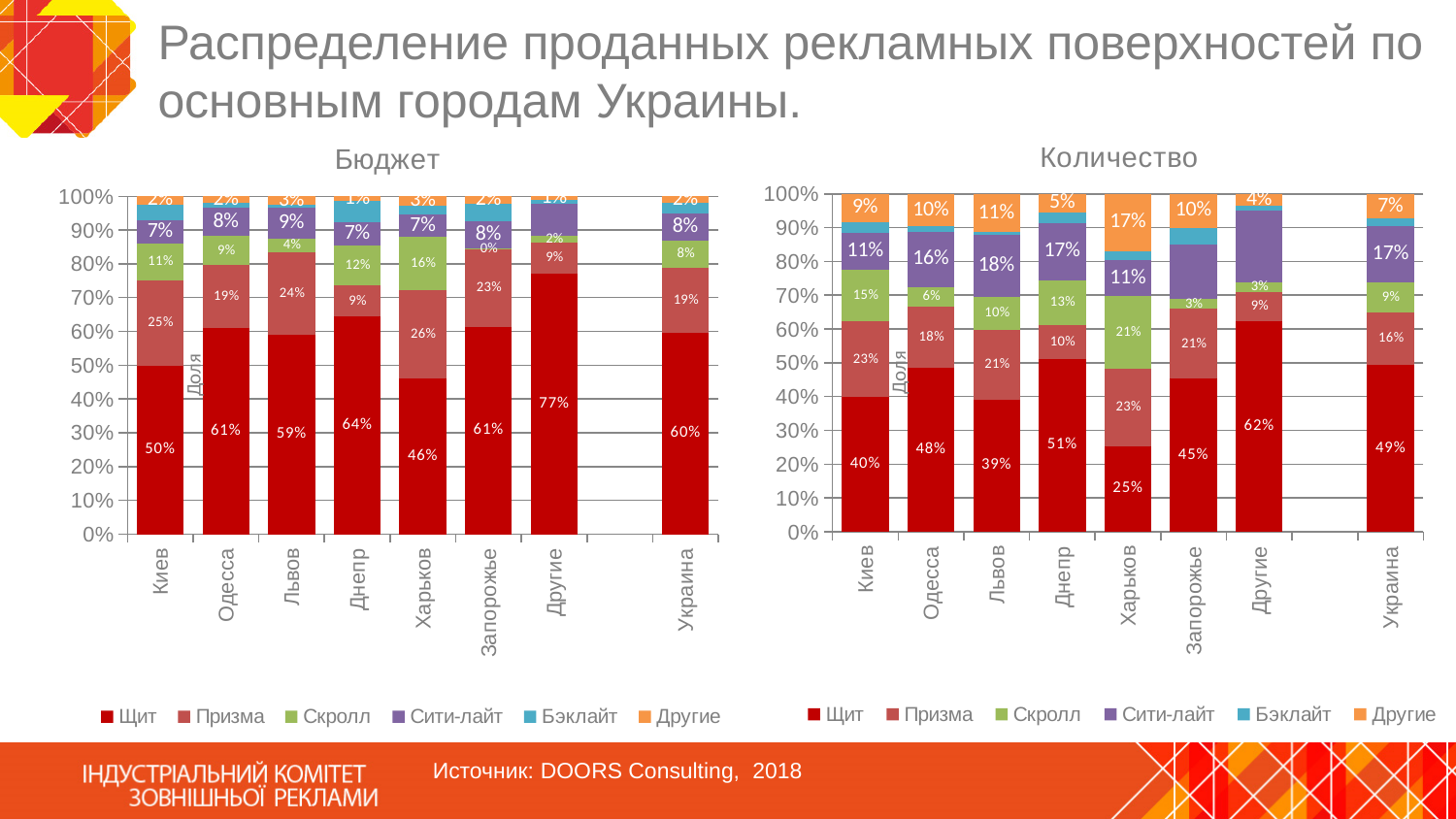
In the "Количество" chart, what is the value of Щит for Харьков? 25% In the "Бюджет" chart, what is the value of Щит for Киев? 50% In the "Количество" chart, what is the value of Другие (top segment) for Харьков? 17% In the "Бюджет" chart, which city has the highest Щит share? Другие In the "Бюджет" chart, what is the Призма value for Украина? 19% What type of chart is the "Бюджет" chart? Stacked bar chart How many categories are shown on the x axis of the "Бюджет" chart? 8 In the "Количество" chart, which is larger: the Призма value for Киев or for Днепр? Киев In the "Бюджет" chart, what is the difference between the Щит values for Другие and Харьков? 31% In the "Количество" chart, which category has the lowest Щит share? Харьков How many series does the legend of the "Количество" chart list? 6 What is the title of the chart on the right side of the slide? Количество